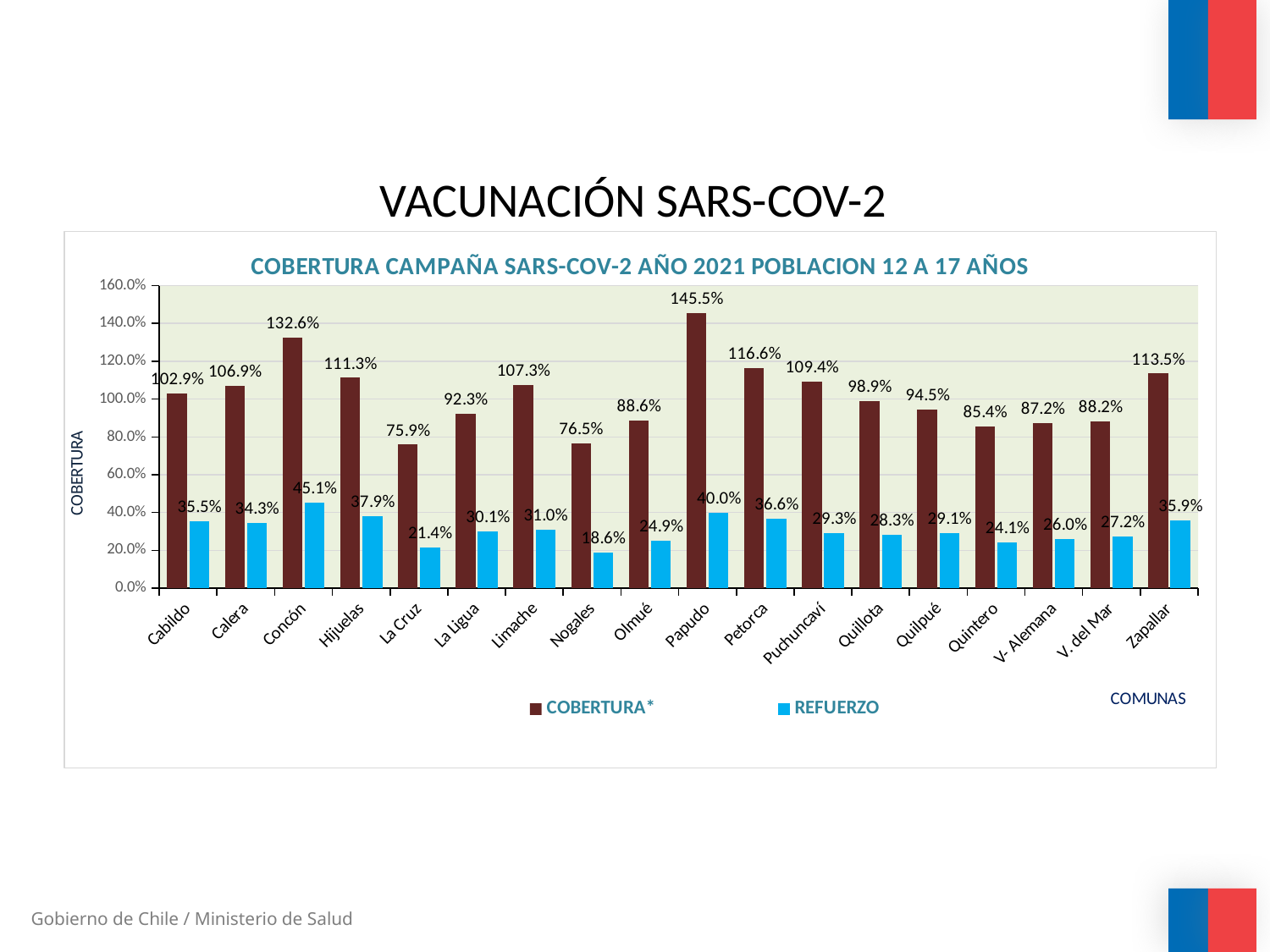
What is the COBERTURA* value for Quillota? 98.9% Which is larger, the COBERTURA* value for Concón or for Zapallar? Concón Which comuna has the lowest REFUERZO value? Nogales What type of chart is shown? Bar chart What is the COBERTURA* value for Papudo? 145.5% What is the difference between the COBERTURA* and REFUERZO values for Papudo? 105.5% What is the REFUERZO value for Nogales? 18.6% Which comuna has the highest REFUERZO value? Concón How many series does the legend list? 2 Is the COBERTURA* value for La Cruz greater or less than 80.0%? less Which comuna has the highest COBERTURA* value? Papudo How many comunas are shown on the x axis? 18